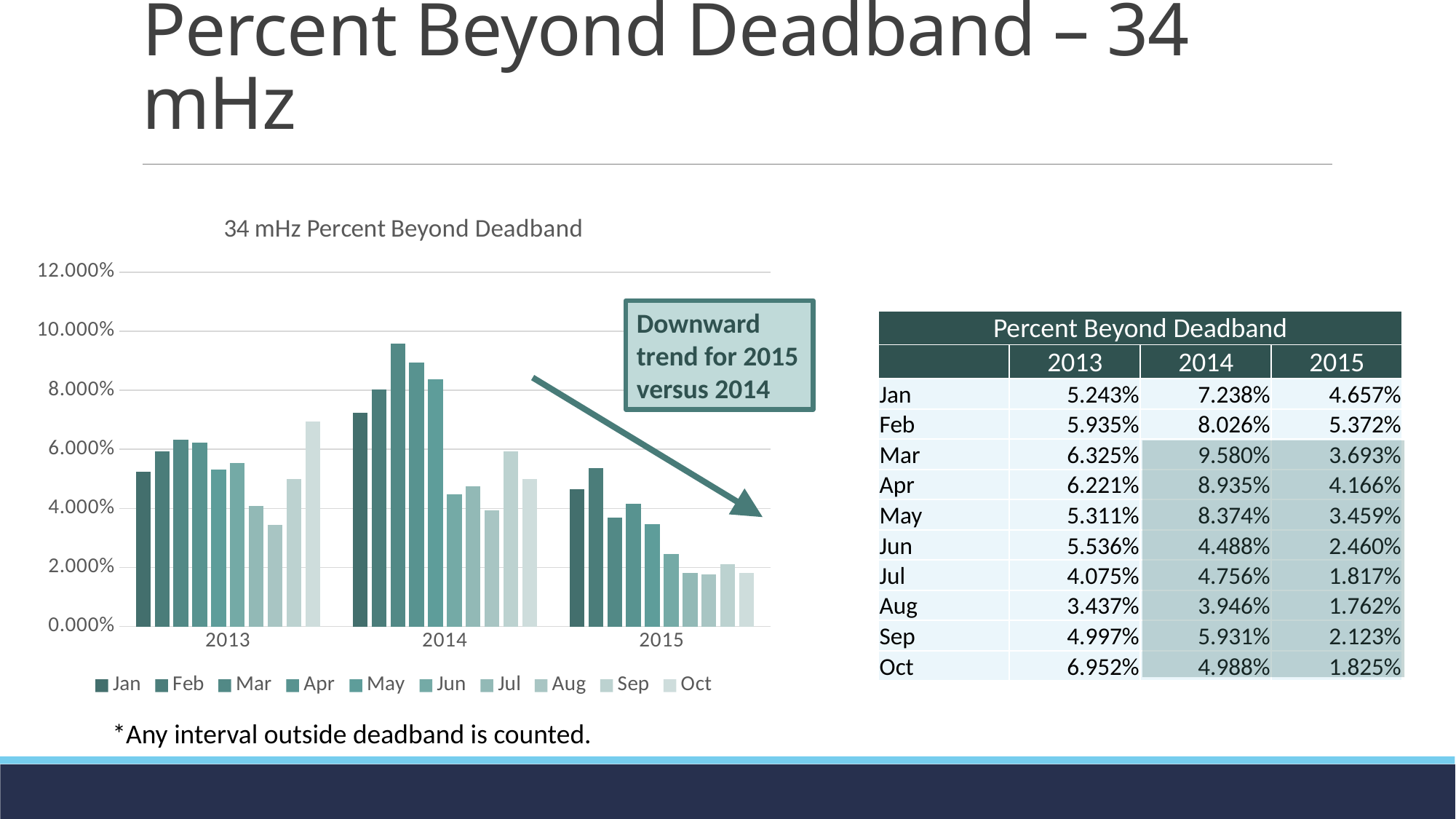
Which month has the lowest bar in the 2013 group? Aug Which month has the highest bar in the 2014 group? Mar Within the 2015 group, do the bars generally rise or fall from Jan to Oct? fall Is the value for Jun in 2015 greater or less than 4.000%? less Which is larger, the Jan value for 2014 or the Jan value for 2015? 2014 How many series does the chart legend list? 10 What kind of chart is shown on the slide? bar chart Is the value for Mar in 2014 greater or less than 8.000%? greater What is the title of the chart? 34 mHz Percent Beyond Deadband How many year categories are shown on the x axis of the chart? 3 According to the table, what is the Percent Beyond Deadband for Mar 2014? 9.580% Using the table values, what is the difference between the Jan value for 2014 and the Jan value for 2015? 2.581%